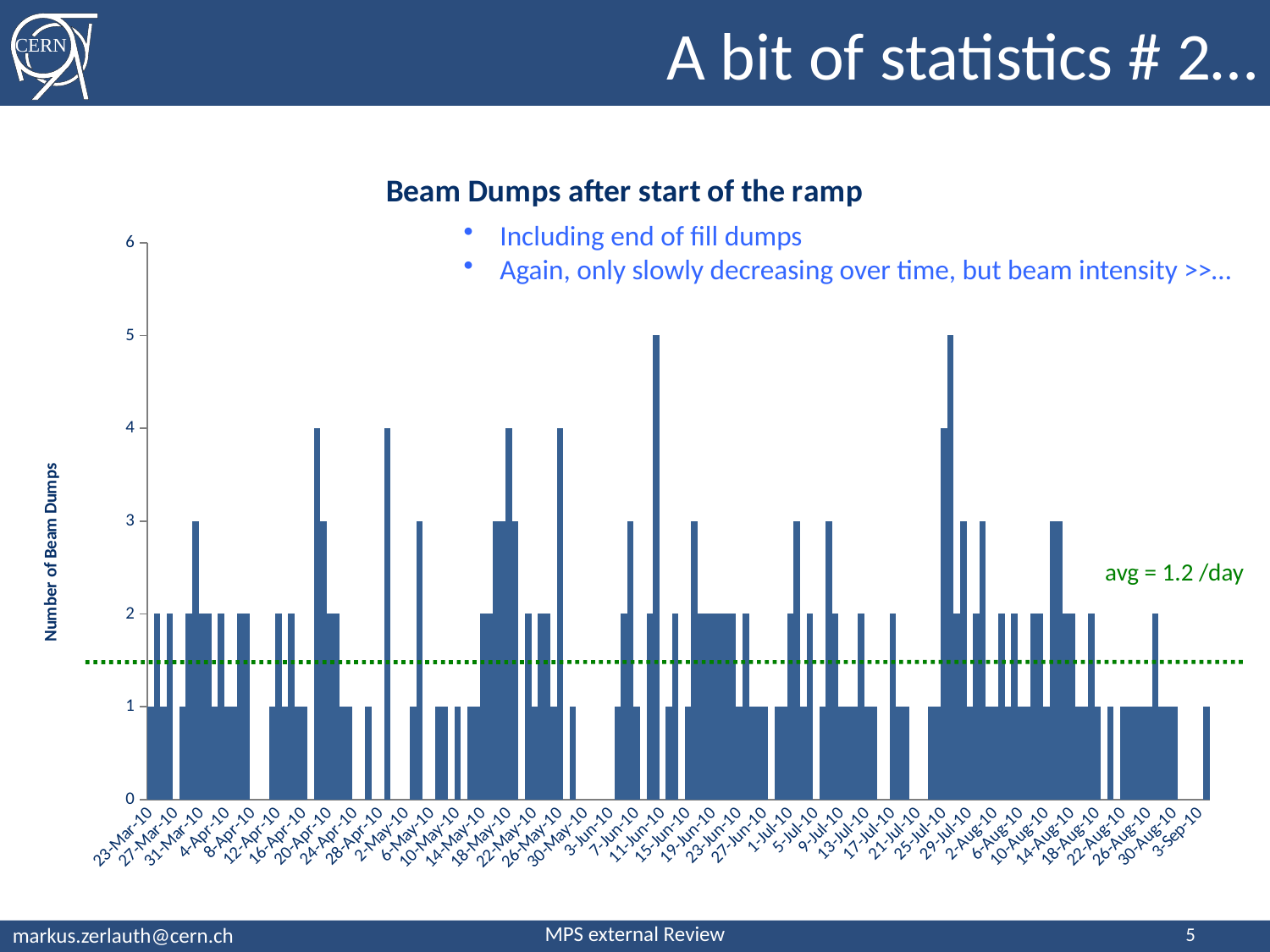
What is the highest number of beam dumps reached on any single day in the chart? 5 Is the dotted average line greater or less than 1 on the vertical axis? greater What is the first date label on the horizontal axis? 23-Mar-10 What is the label of the vertical axis of the chart? Number of Beam Dumps What kind of chart is shown on the slide? Bar chart Does any bar in the chart exceed 5 beam dumps? No How many days in the chart reach a value of 5 beam dumps? 2 What is the last date label on the horizontal axis? 3-Sep-10 Is the dotted average line greater or less than 2 on the vertical axis? less What is the title of the chart? Beam Dumps after start of the ramp What average value is annotated on the chart? avg = 1.2 /day What is the maximum value shown on the vertical axis? 6